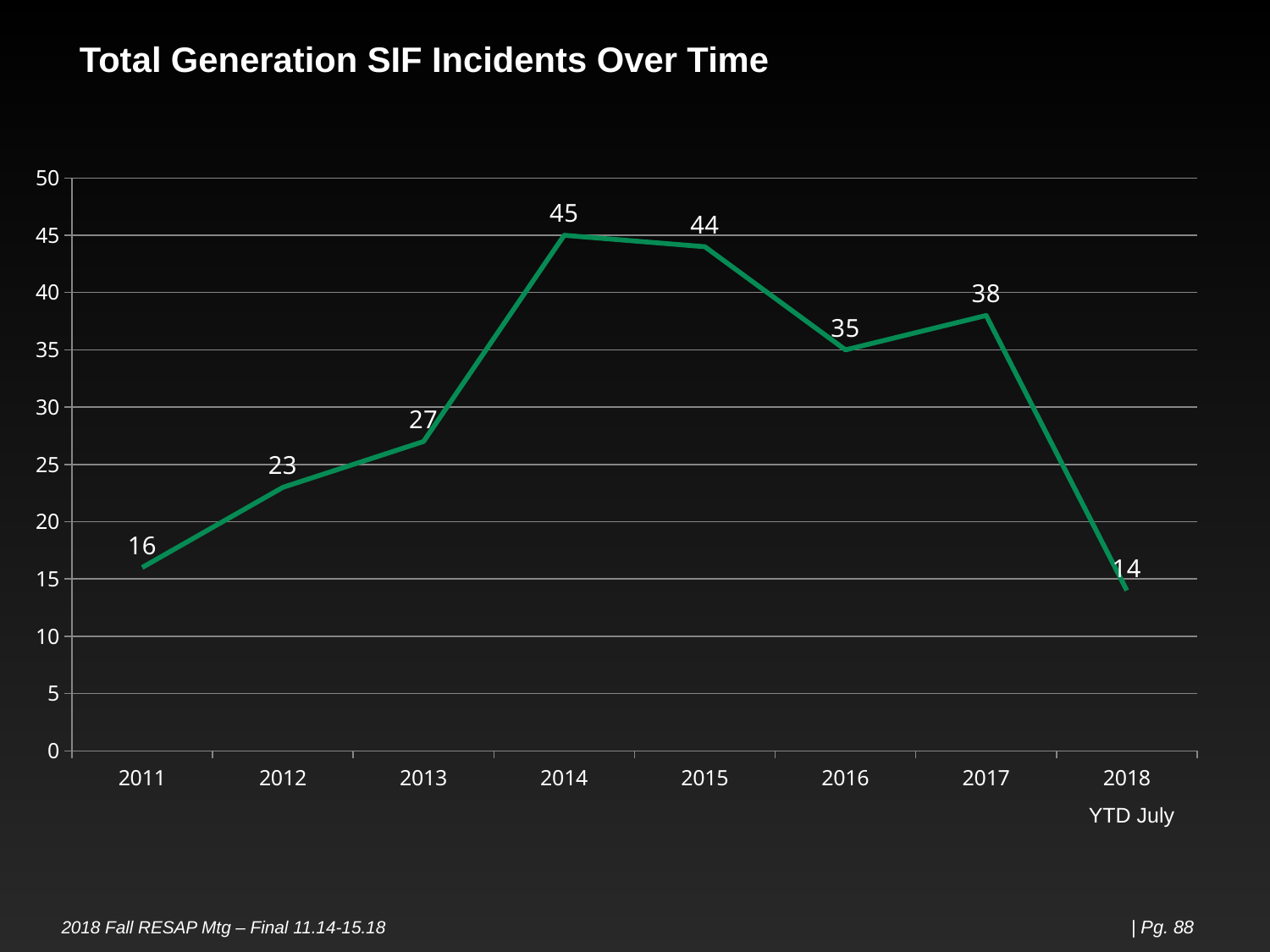
What kind of chart is this? line chart Do the values rise or fall from 2011 to 2014? rise Which year has the highest value? 2014 What is the value for 2011? 16 Which is larger, the value for 2013 or the value for 2016? 2016 What is the difference between the values for 2014 and 2011? 29 Which year has the lowest value? 2018 What is the value for 2014? 45 What is the title of the chart? Total Generation SIF Incidents Over Time What is the difference between the values for 2017 and 2016? 3 How many years are plotted on the chart? 8 What is the value for 2018? 14